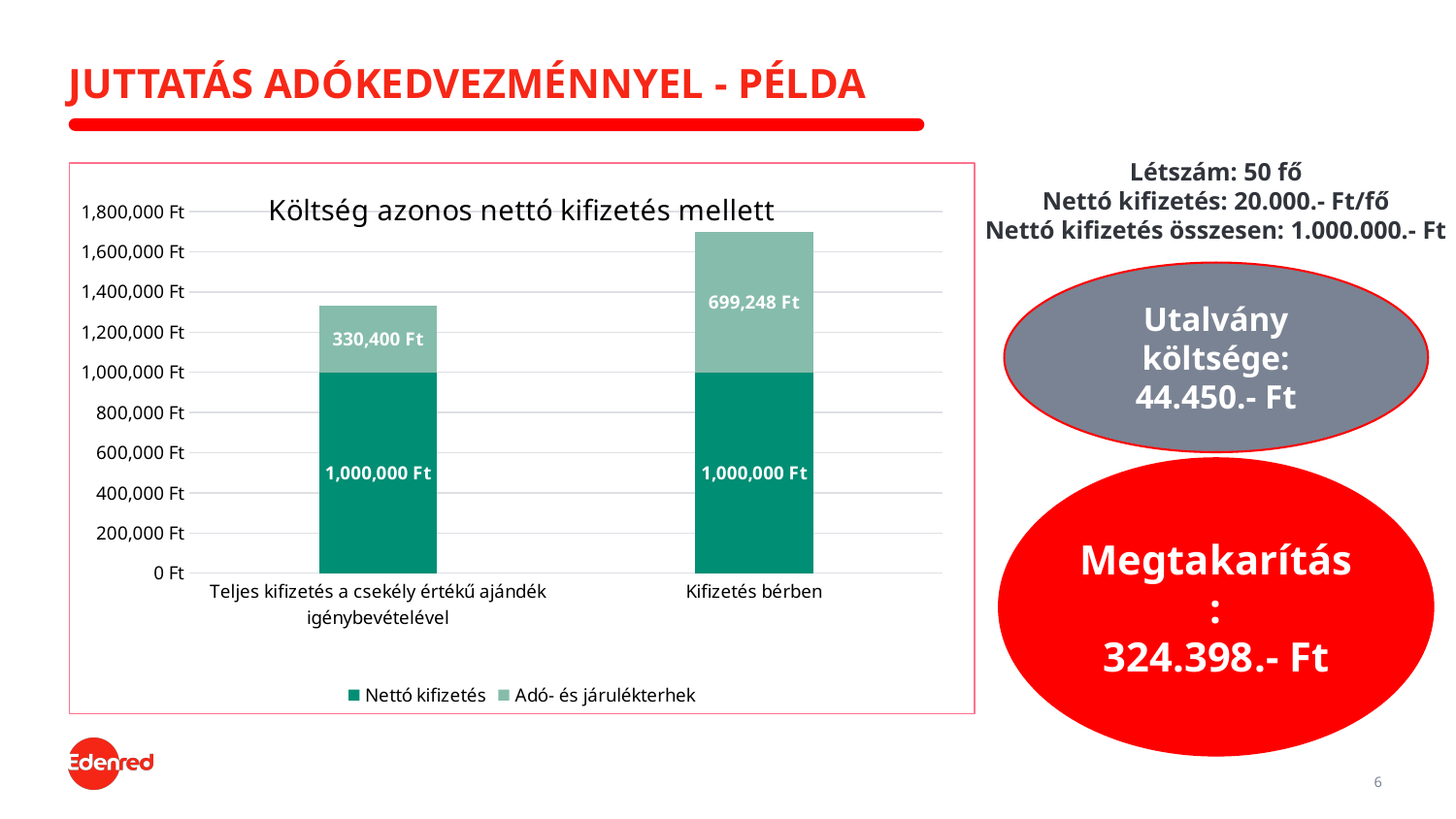
What is the difference in Adó- és járulékterhek between Kifizetés bérben and Teljes kifizetés a csekély értékű ajándék igénybevételével? 368,848 Ft What type of chart is shown on the slide? stacked bar chart What is the total of the stacked bar for Teljes kifizetés a csekély értékű ajándék igénybevételével? 1,330,400 Ft What is the title of the chart? Költség azonos nettó kifizetés mellett What is the total of the stacked bar for Kifizetés bérben? 1,699,248 Ft What is the value of Nettó kifizetés for Kifizetés bérben? 1,000,000 Ft What is the value of Adó- és járulékterhek for Kifizetés bérben? 699,248 Ft How many series does the chart legend list? 2 How many categories are shown on the x axis of the chart? 2 Which series is shown in the darker green colour in the chart? Nettó kifizetés What is the value of Adó- és járulékterhek for Teljes kifizetés a csekély értékű ajándék igénybevételével? 330,400 Ft Which category has the higher Adó- és járulékterhek value? Kifizetés bérben